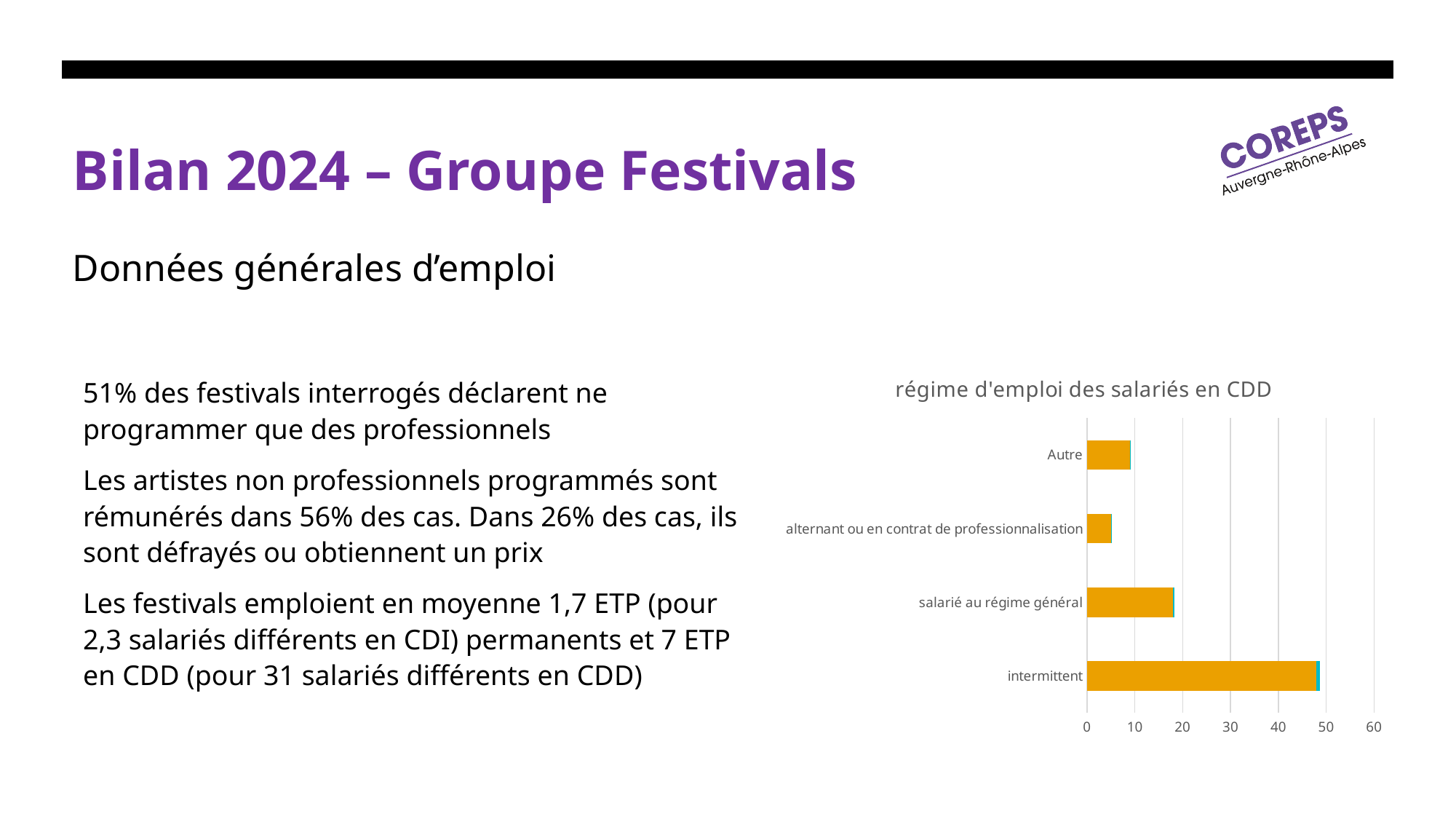
What kind of chart is shown on the slide? bar chart Which category has the highest value? intermittent Which category has the lowest value? alternant ou en contrat de professionnalisation What is the title of the chart? régime d'emploi des salariés en CDD Is the value for salarié au régime général greater or less than 10? greater Is the value for salarié au régime général greater or less than 20? less Is the value for intermittent greater or less than 50? less How many categories does the chart show? 4 Which is larger, the value for Autre or the value for alternant ou en contrat de professionnalisation? Autre Which is larger, the value for salarié au régime général or the value for intermittent? intermittent